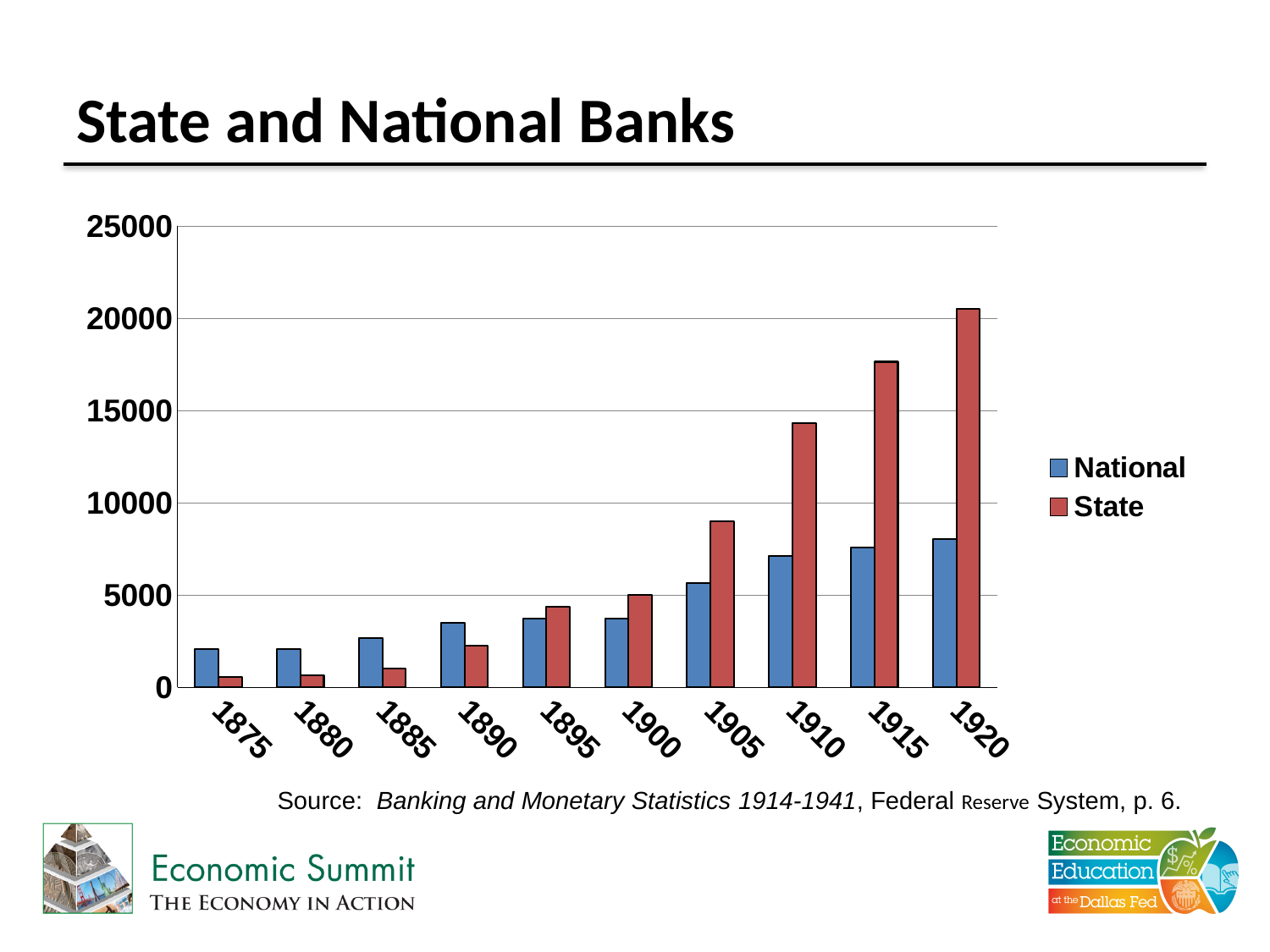
How many series does the legend list? 2 In which year is the National series highest? 1920 In 1875, which is larger, National or State? National What kind of chart is shown on the slide? bar chart In which year is the State series highest? 1920 Is the value for State in 1915 greater or less than 15000? greater Does the State series generally rise or fall from 1875 to 1920? rise Is the value for National in 1905 greater or less than 5000? greater Is the value for State in 1905 greater or less than 10000? less How many years are shown along the x axis? 10 In 1920, which is larger, National or State? State